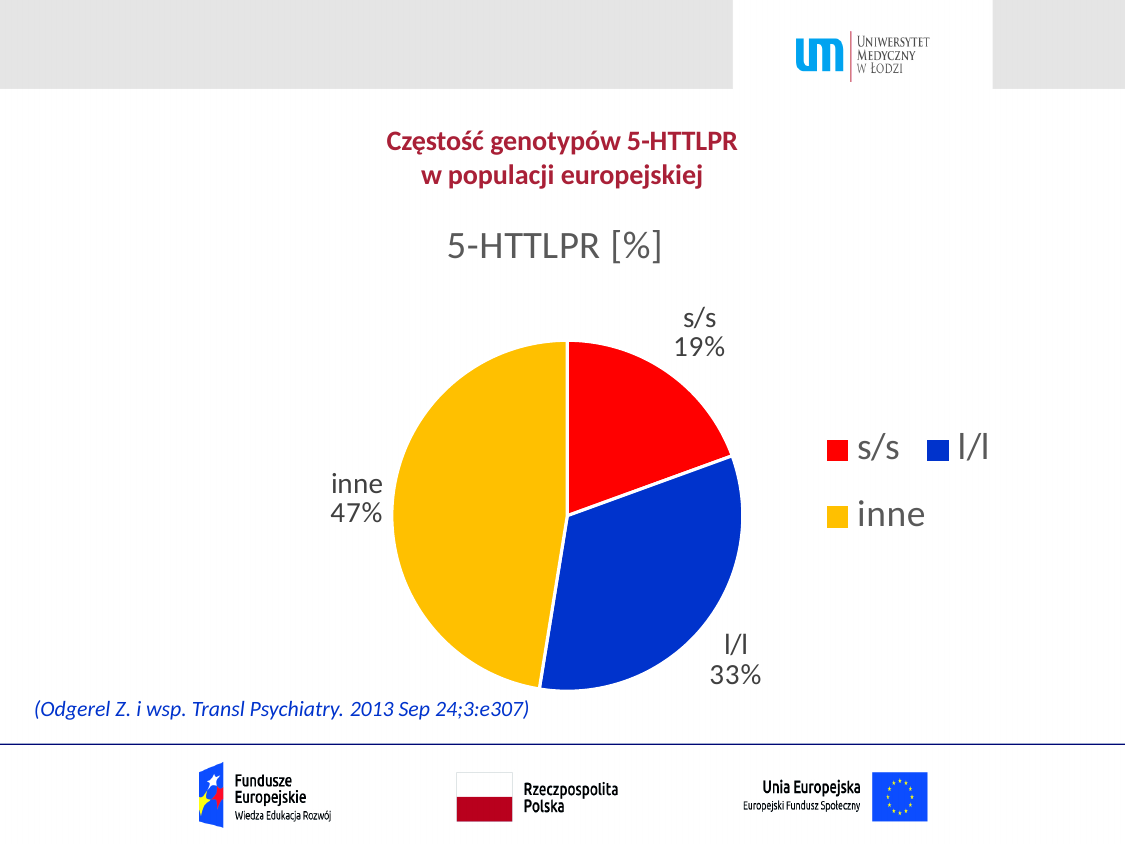
What percentage does the l/l slice represent? 33% What percentage does the inne slice represent? 47% How many slices does the pie chart have? 3 Which category has the largest share of the pie? inne What is the difference in percentage points between the inne and l/l slices? 14 Which category has the smallest share of the pie? s/s What percentage does the s/s slice represent? 19% What is the difference in percentage points between the l/l and s/s slices? 14 What type of chart is shown on the slide? pie chart How many entries does the legend list? 3 What is the title of the chart? 5-HTTLPR [%] Which is larger, the l/l slice or the s/s slice? l/l